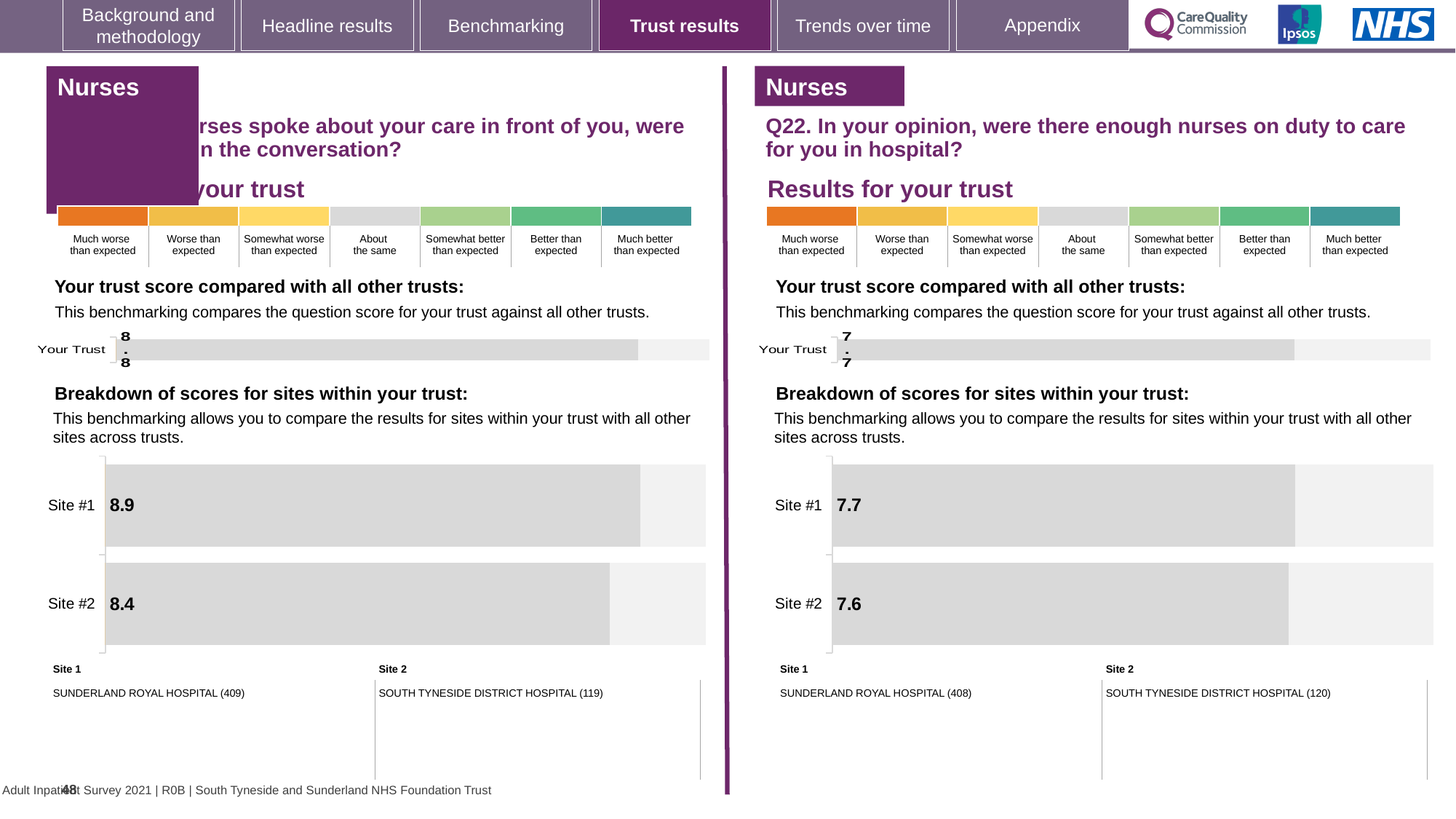
On the right-hand (Q22) 'Your trust score compared with all other trusts' chart, what is the score for Your Trust? 7.7 On the right-hand (Q22) site breakdown chart, what is the score for Site #1? 7.7 On the left-hand site breakdown chart, what is the score for Site #1? 8.9 On the left-hand 'Your trust score compared with all other trusts' chart, what is the score for Your Trust? 8.8 On the left-hand site breakdown chart, what is the score for Site #2? 8.4 How many sites are shown on the right-hand (Q22) site breakdown chart? 2 On the right-hand (Q22) site breakdown chart, what is the score for Site #2? 7.6 On the left-hand site breakdown chart, which site has the higher score? Site #1 What type of chart is the left-hand site breakdown chart? Bar chart On the left-hand site breakdown chart, what is the difference between the Site #1 and Site #2 scores? 0.5 Is the Site #1 score on the left-hand site breakdown chart larger than the Site #1 score on the right-hand (Q22) site breakdown chart? Yes On the right-hand (Q22) site breakdown chart, what is the difference between the Site #1 and Site #2 scores? 0.1